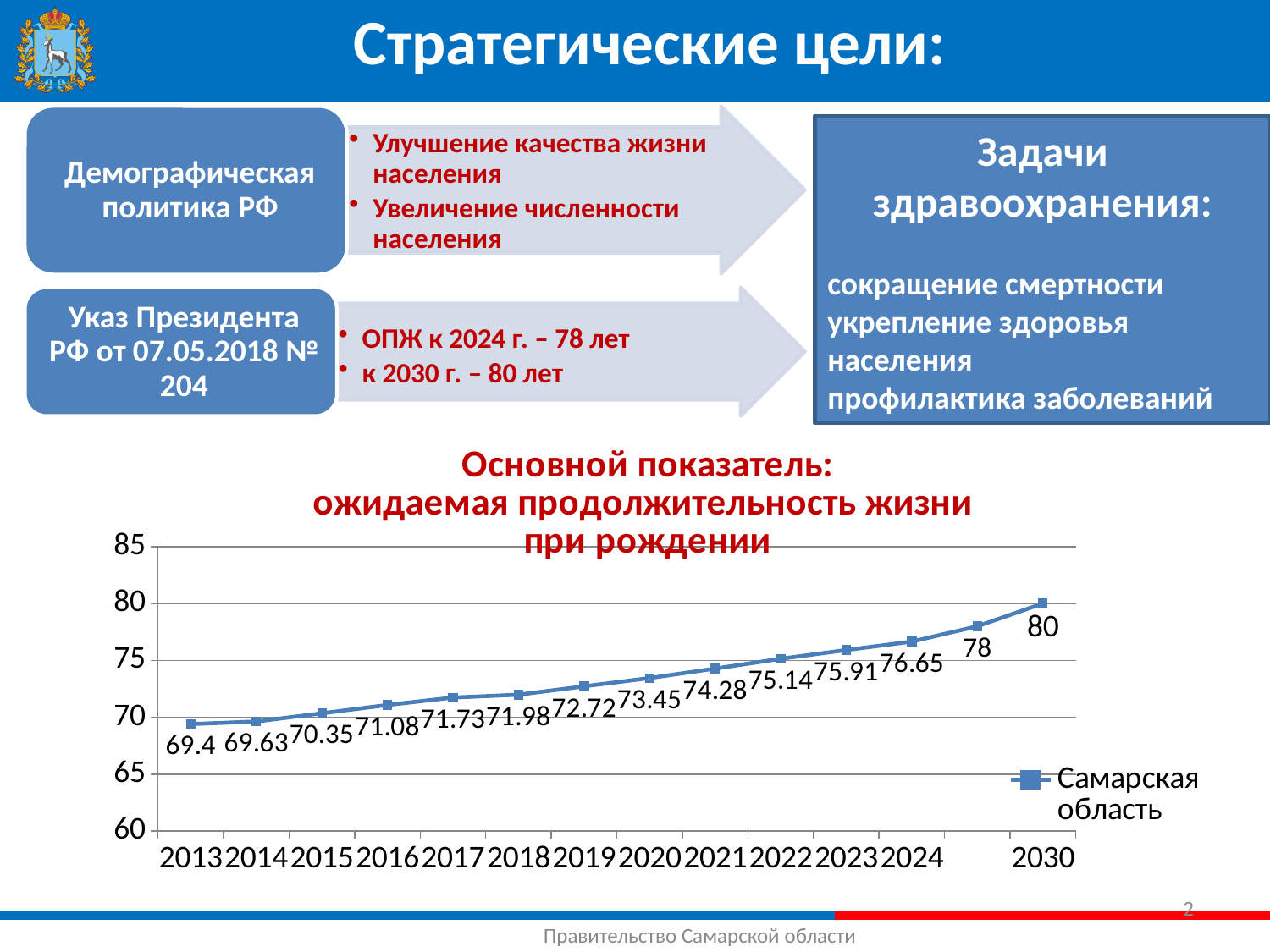
What value is shown for 2020? 73.45 Which is larger, the value for 2018 or the value for 2019? 2019 How many series does the legend list? 1 Which year has the highest value on the chart? 2030 What value is shown for 2030? 80 What kind of chart is shown on the slide? line chart What is the name of the series in the legend? Самарская область What value is shown for 2024? 76.65 What is the expected life expectancy at birth for Самарская область in 2013? 69.4 What is the difference between the values for 2024 and 2013? 7.25 Do the values rise or fall from 2013 to 2030? rise Which year has the lowest value on the chart? 2013